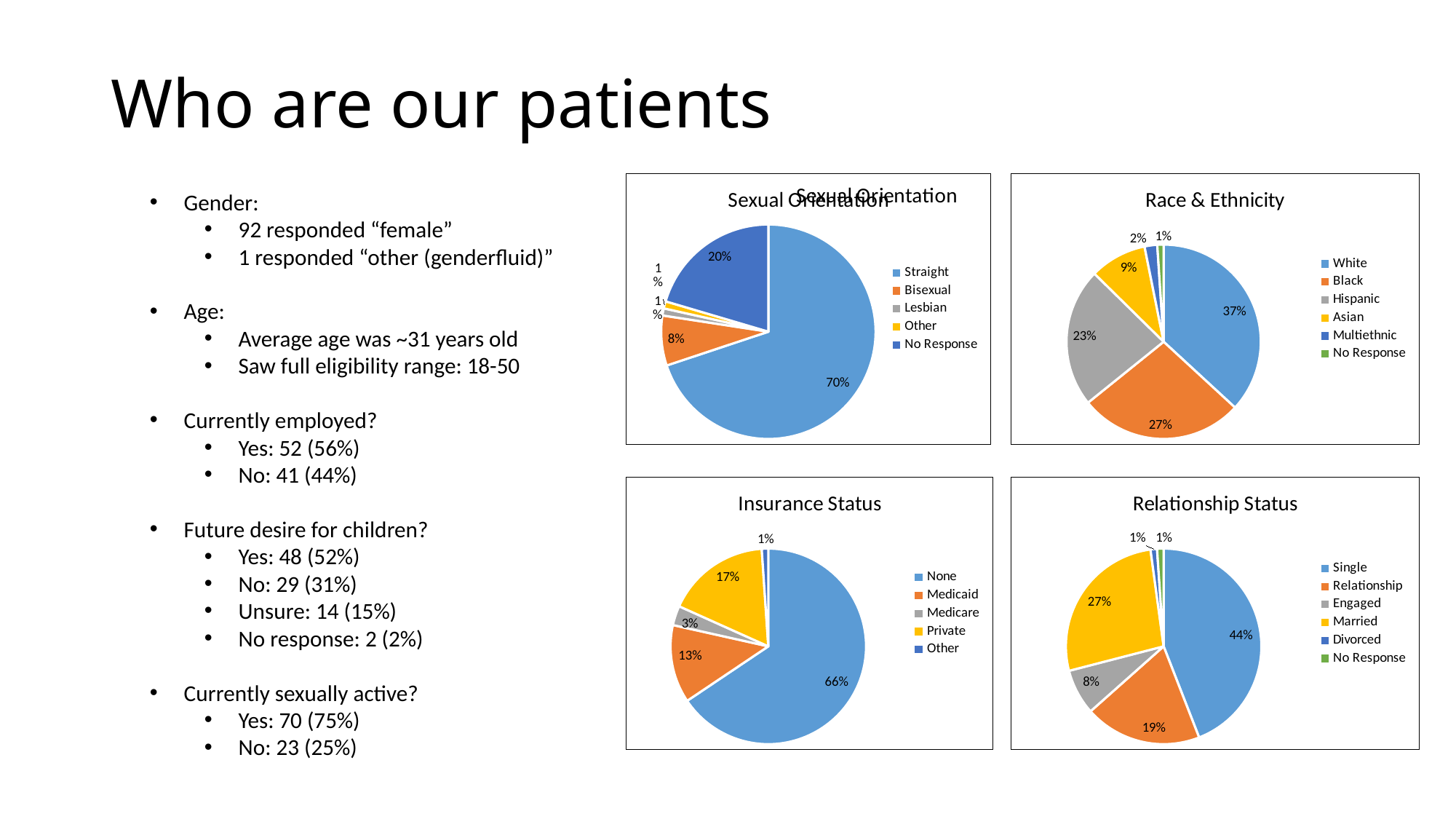
In the Insurance Status chart, what percentage is shown for Private? 17% In the Race & Ethnicity chart, which category has the largest share? White What type of chart is the Insurance Status chart? Pie chart In the Sexual Orientation chart, what share of patients responded Straight? 70% In the Relationship Status chart, what percentage is shown for Married? 27% In the Insurance Status chart, which is larger, Medicaid or Medicare? Medicaid In the Sexual Orientation chart, what percentage is shown for No Response? 20% In the Relationship Status chart, what is the difference between the Single and Relationship shares? 25% How many categories does the legend of the Race & Ethnicity chart list? 6 In the Race & Ethnicity chart, what percentage is shown for Hispanic? 23% In the Insurance Status chart, which category has the smallest share? Other In the Race & Ethnicity chart, what is the difference between the White and Black shares? 10%